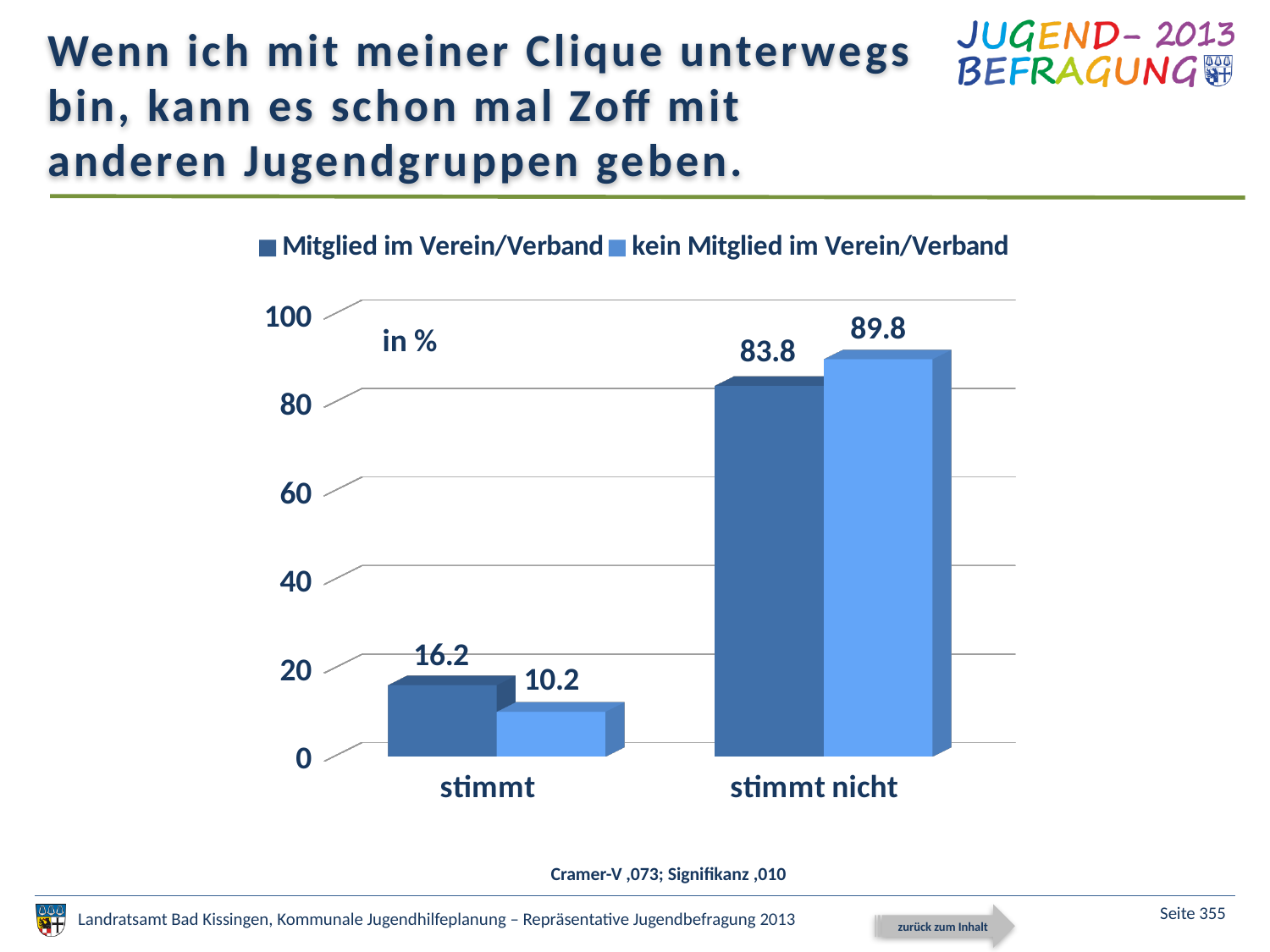
How many categories are shown on the x axis? 2 In the "stimmt" category, which series has the larger value? Mitglied im Verein/Verband What kind of chart is shown on the slide? bar chart What is the value for "Mitglied im Verein/Verband" in the "stimmt nicht" category? 83.8 How many series does the legend list? 2 What is the value for "kein Mitglied im Verein/Verband" in the "stimmt nicht" category? 89.8 What is the difference between the two series in the "stimmt nicht" category? 6 What is the difference between the two series in the "stimmt" category? 6 What is the value for "Mitglied im Verein/Verband" in the "stimmt" category? 16.2 Which bar has the highest value in the chart? kein Mitglied im Verein/Verband, stimmt nicht What is the value for "kein Mitglied im Verein/Verband" in the "stimmt" category? 10.2 Which bar has the lowest value in the chart? kein Mitglied im Verein/Verband, stimmt